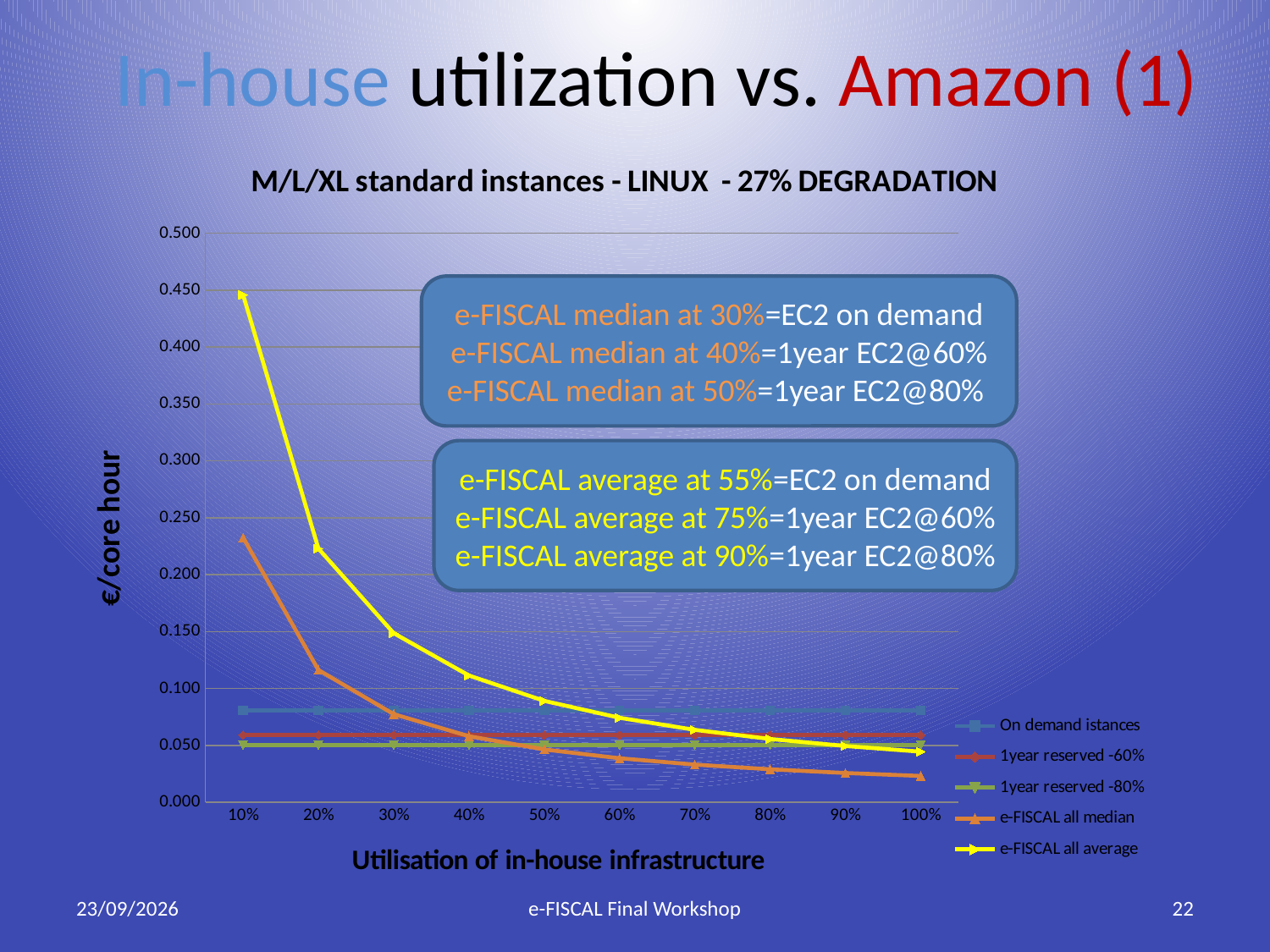
What is the title of the chart? M/L/XL standard instances - LINUX - 27% DEGRADATION Does the e-FISCAL all average line rise or fall as utilisation increases from 10% to 100%? fall What is the label of the y axis? €/core hour How many utilisation levels are shown along the x axis? 10 Is the value of e-FISCAL all average at 10% utilisation greater or less than 0.400? greater How many series does the chart legend list? 5 At 100% utilisation, which is larger: On demand istances or e-FISCAL all median? On demand istances What kind of chart is shown on the slide? line chart Is the value of On demand istances at 50% utilisation greater or less than 0.100? less At 10% utilisation, which is larger: e-FISCAL all average or e-FISCAL all median? e-FISCAL all average Which series has the lowest value at 100% utilisation? e-FISCAL all median Is the value of e-FISCAL all median at 10% utilisation greater or less than 0.200? greater